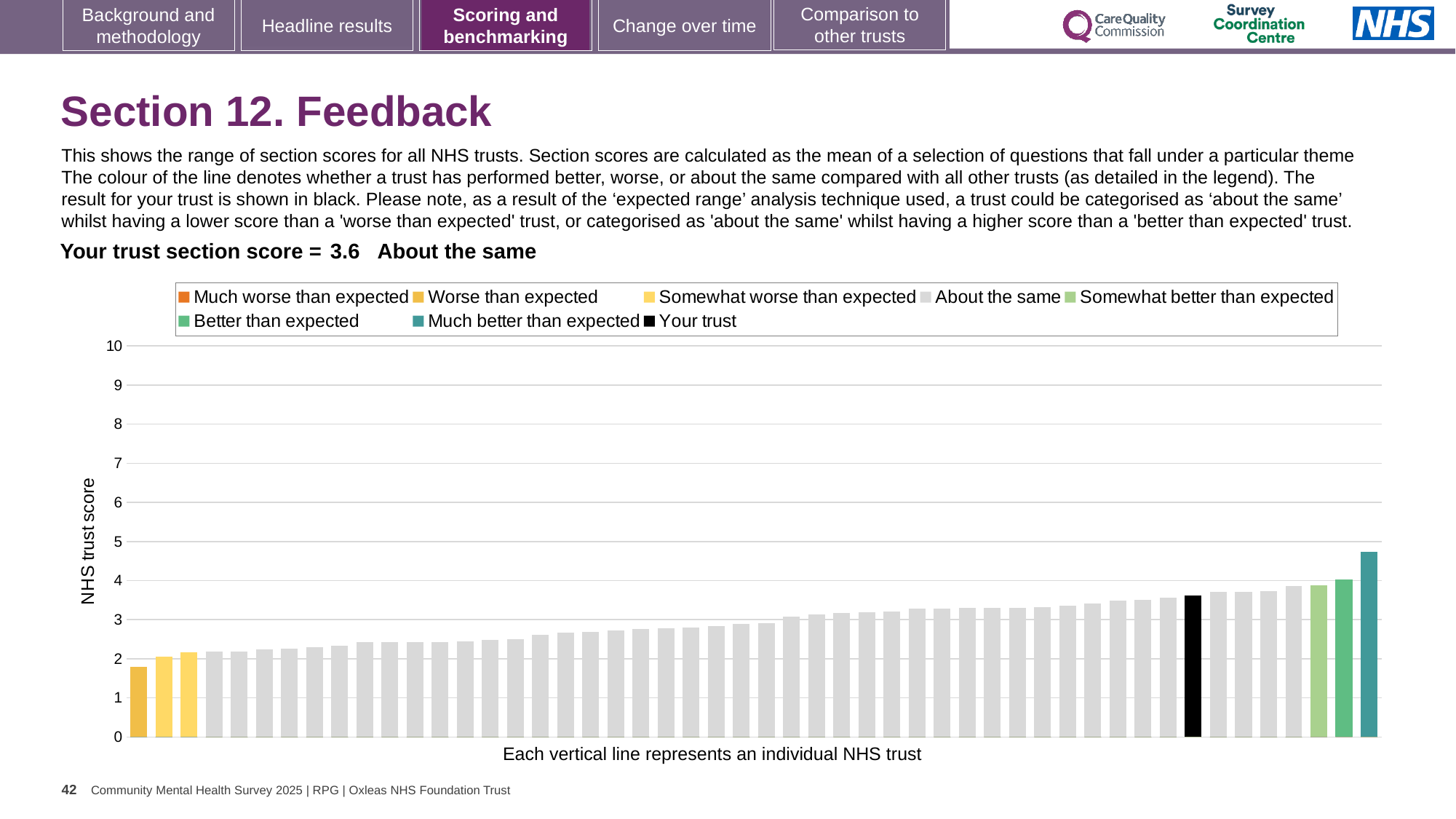
What is the label on the y axis of the chart? NHS trust score How many entries does the chart legend list? 8 Is the value of the tallest bar greater or less than 4? greater Which category is your trust's section score placed in? About the same What is the section score for your trust shown on the slide? 3.6 Which legend category does the tallest bar belong to? Much better than expected Do the bar values rise or fall from left to right along the x axis? rise Is the value of the shortest bar greater or less than 2? less What kind of chart is shown on the slide? bar chart Is the value for your trust (the black bar) greater or less than 4? less What colour is the bar representing your trust? black